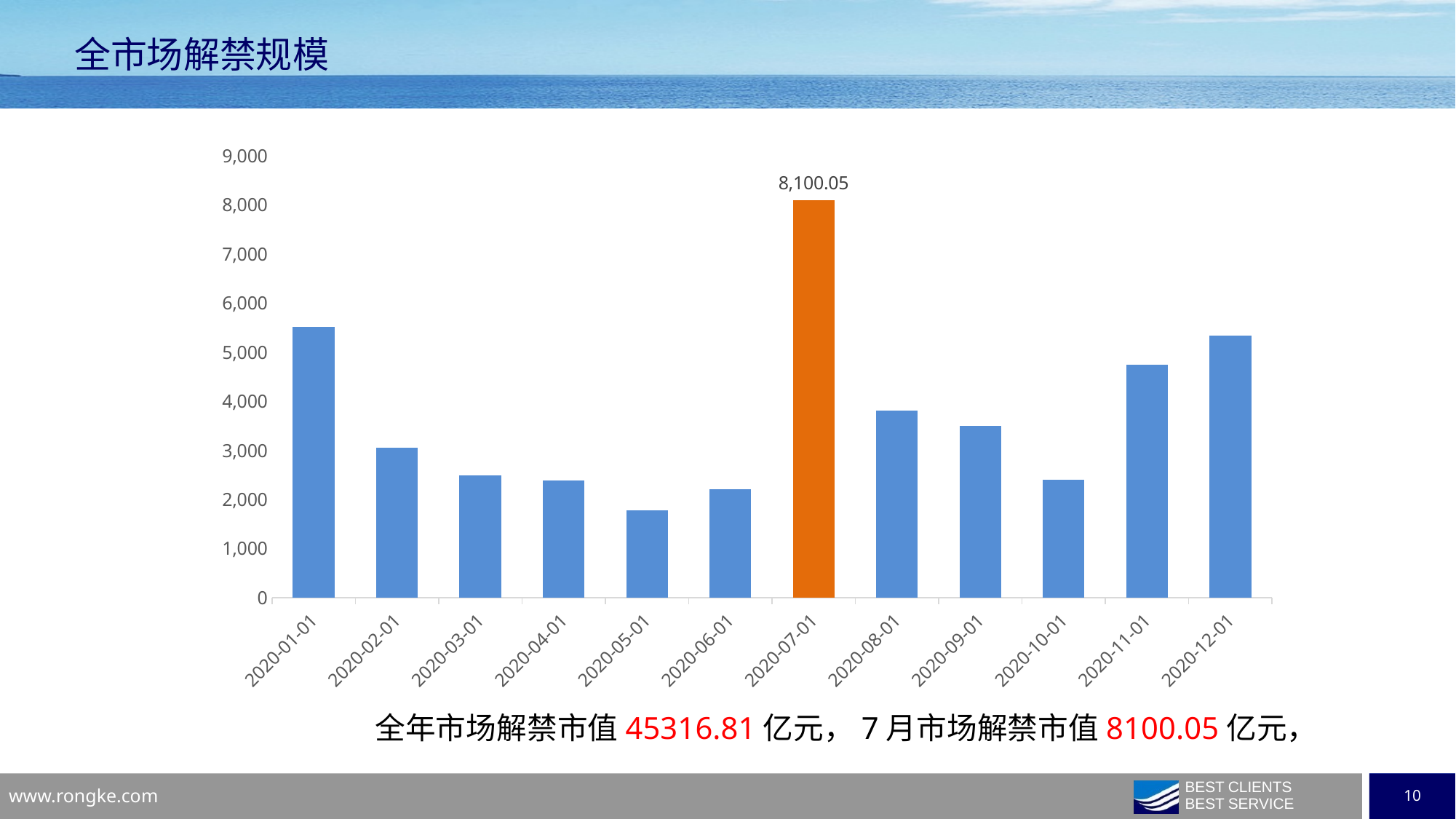
How many months (bars) are plotted on the chart? 12 Is the value for 2020-05-01 greater or less than 2,000? less What kind of chart is shown on the slide? Bar chart What colour is the bar for 2020-07-01? Orange Do the values rise or fall from 2020-01-01 to 2020-05-01? fall Is the value for 2020-11-01 greater or less than 4,000? greater Which is larger, the value for 2020-01-01 or the value for 2020-11-01? 2020-01-01 Which month has the highest bar? 2020-07-01 Is the value for 2020-03-01 greater or less than 3,000? less What is the value shown for 2020-07-01? 8,100.05 Which month has the lowest bar? 2020-05-01